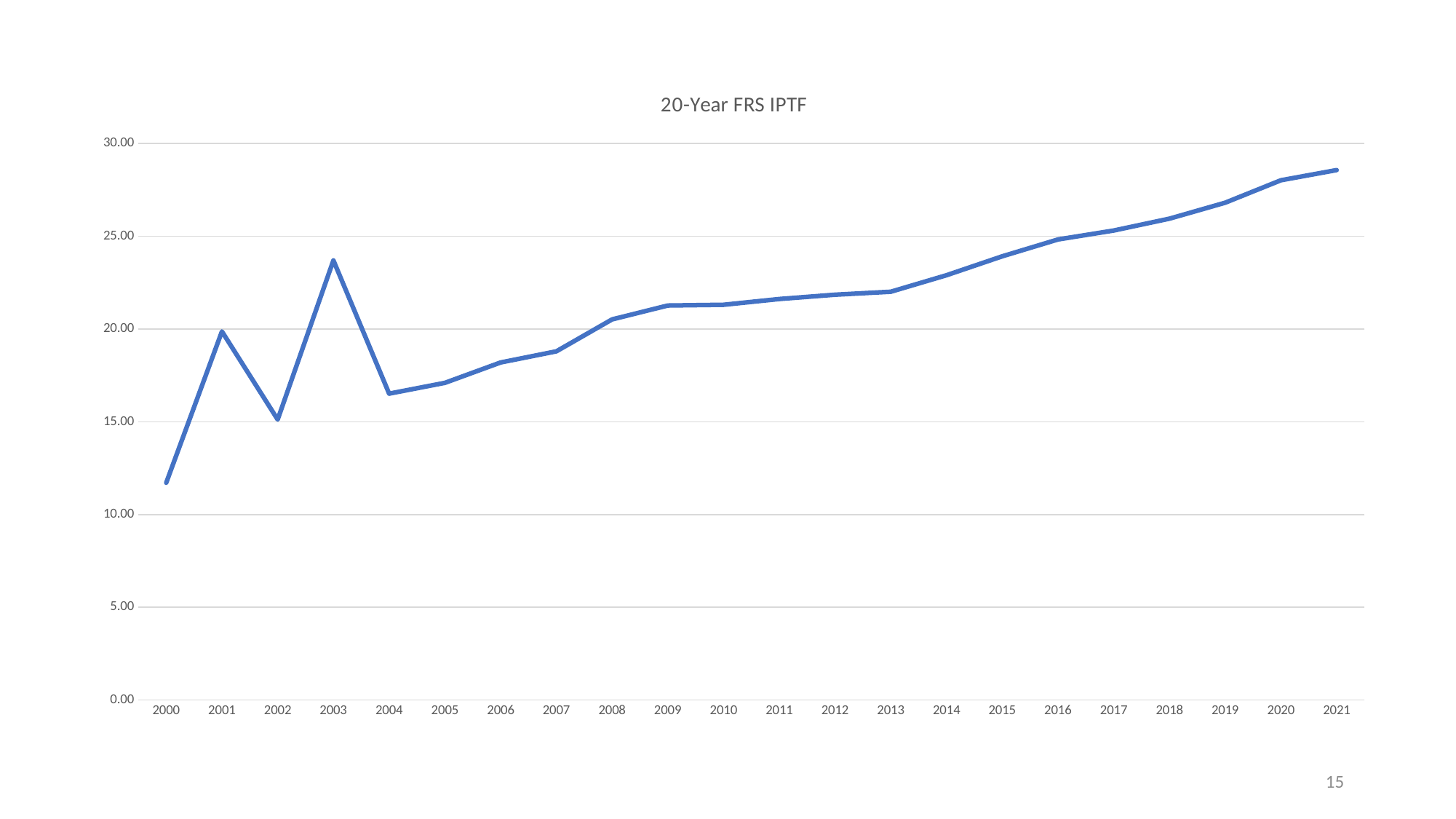
Is the value for 2000 greater or less than 15.00? less Which year has the larger value, 2001 or 2003? 2003 Which year has the highest value? 2021 Do the values generally rise or fall from 2004 to 2021? rise What kind of chart is shown on the slide? line chart Which year has the larger value, 2002 or 2004? 2004 Is the value for 2003 greater or less than 20.00? greater What is the title of the chart? 20-Year FRS IPTF Is the value for 2021 greater or less than 25.00? greater How many years are plotted along the x axis? 22 Which year has the lowest value? 2000